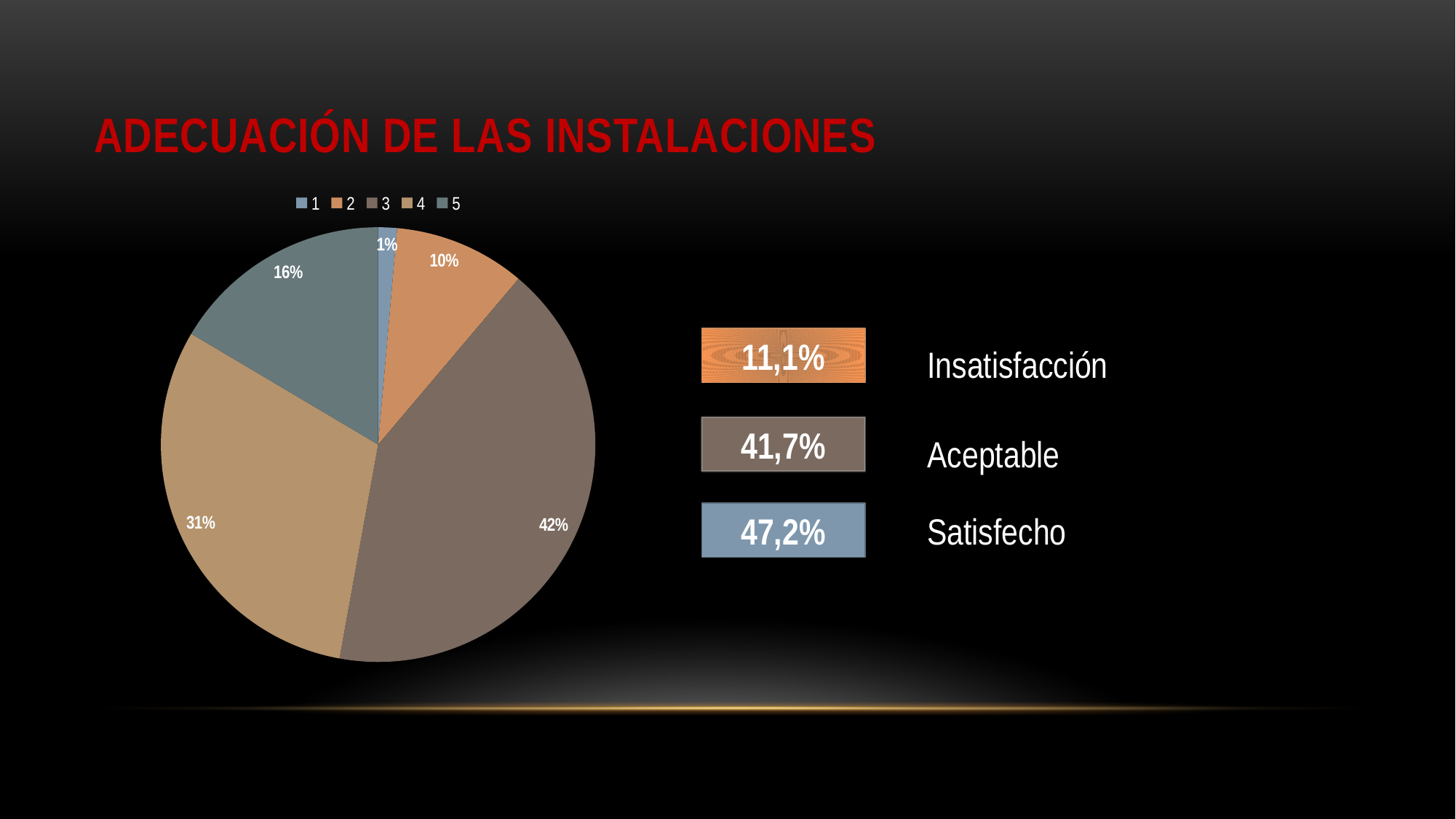
Which category has the smallest slice in the pie chart? 1 What percentage is shown for category 4 in the pie chart? 31% What percentage is shown for category 5 in the pie chart? 16% Which is larger in the pie chart, the slice for category 5 or the slice for category 2? 5 How many slices does the pie chart have? 5 How many entries does the legend of the pie chart list? 5 What kind of chart is shown on the slide? Pie chart What percentage is shown for category 1 in the pie chart? 1% What percentage is shown for category 3 in the pie chart? 42% What percentage is shown for category 2 in the pie chart? 10% What is the difference in percentage points between category 3 and category 4 in the pie chart? 11 Which category has the largest slice in the pie chart? 3